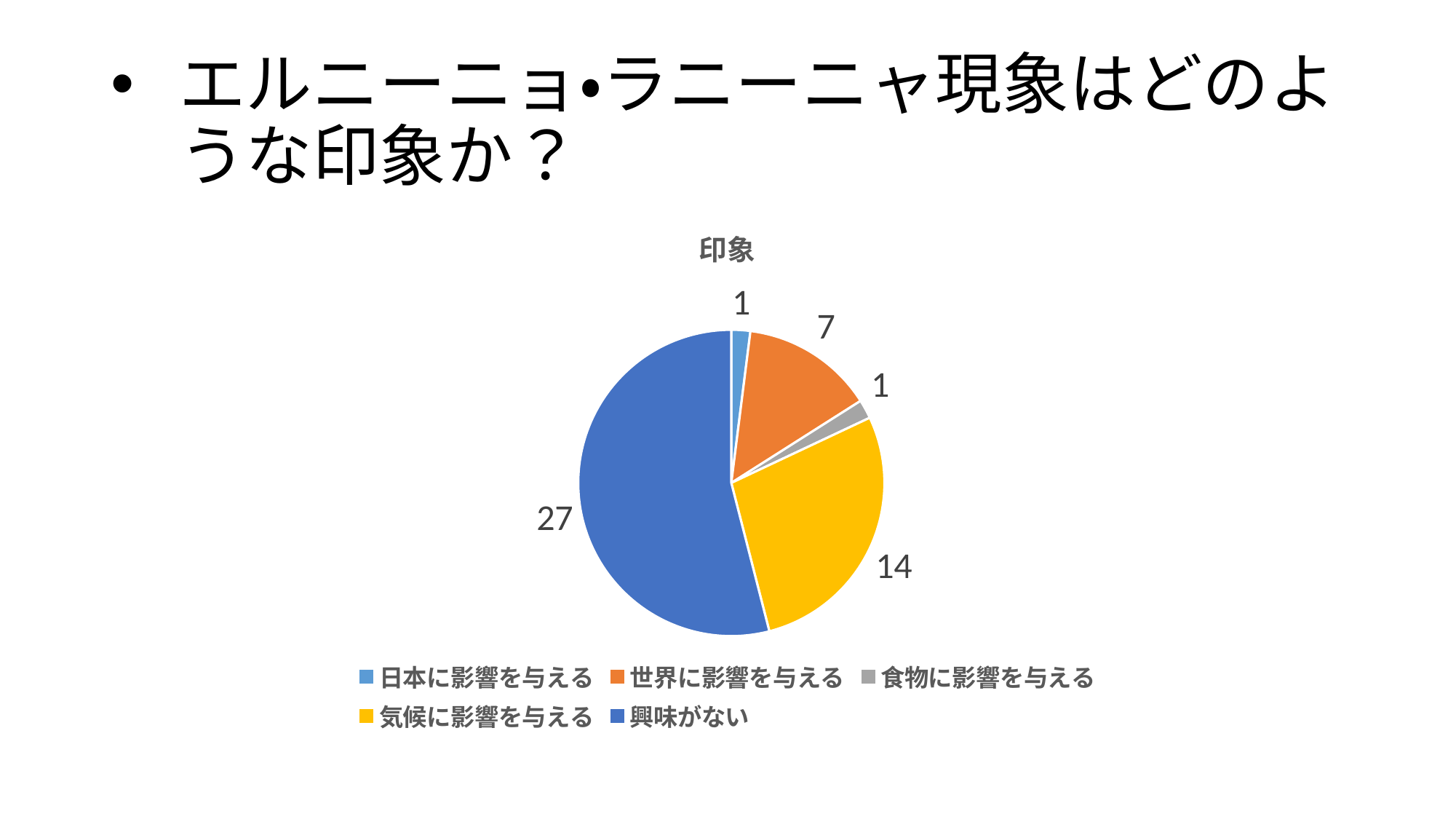
How many categories does the pie chart have? 5 What is the value for 気候に影響を与える? 14 What is the title of the chart? 印象 What is the total of all the slices in the pie chart? 50 What is the difference between the values for 興味がない and 気候に影響を与える? 13 What is the value for 日本に影響を与える? 1 Which is larger, the value for 世界に影響を与える or the value for 気候に影響を与える? 気候に影響を与える What share of the pie does 興味がない represent? 54% What is the value for 興味がない? 27 Which category has the largest slice of the pie? 興味がない What kind of chart is shown on the slide? pie chart What is the value for 世界に影響を与える? 7